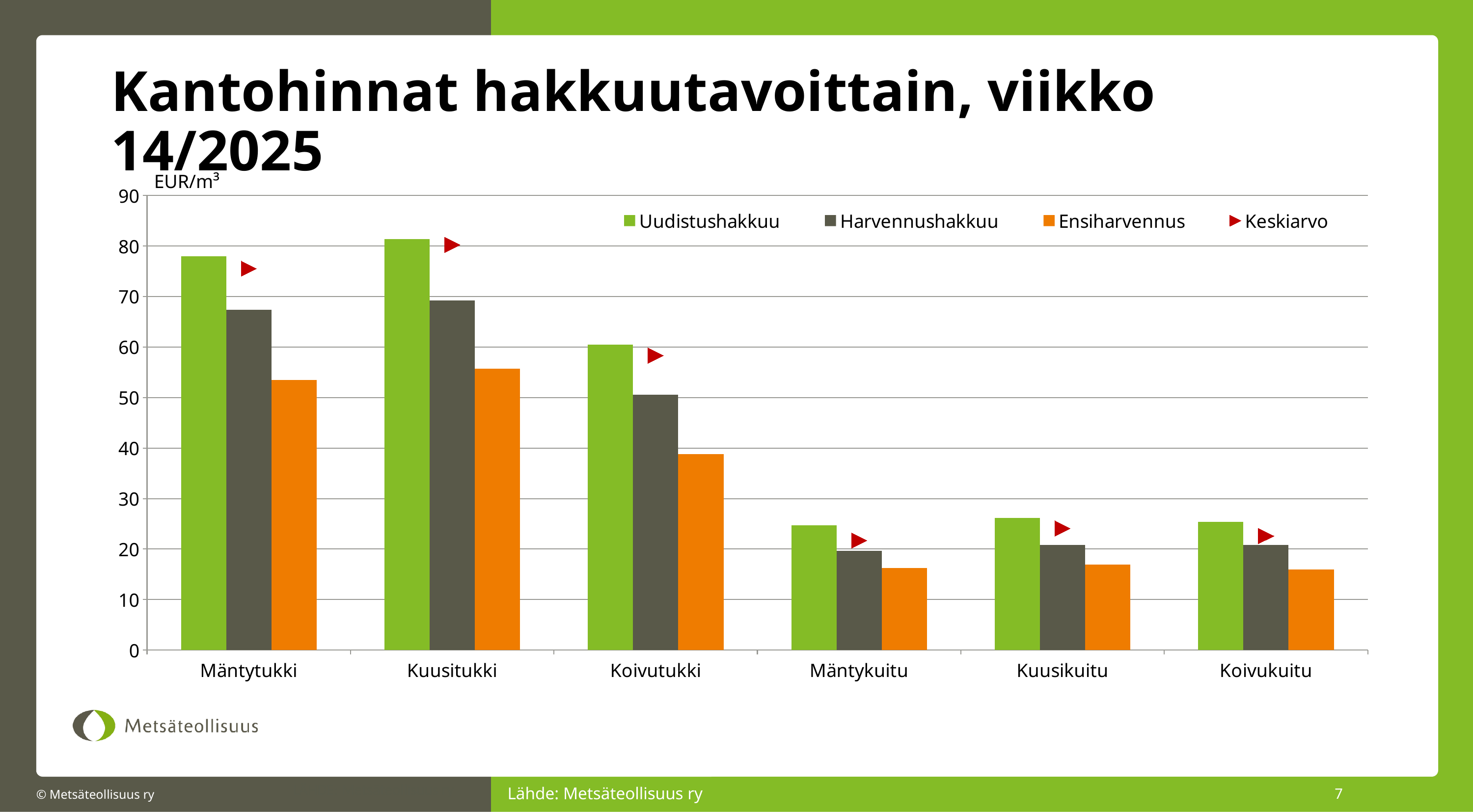
How many series does the legend list? 4 Which is larger: the Harvennushakkuu value for Mäntytukki or the Uudistushakkuu value for Koivutukki? Harvennushakkuu value for Mäntytukki Is the Keskiarvo marker for Kuusitukki greater or less than 70? greater Which is larger: the Uudistushakkuu value for Koivutukki or the Uudistushakkuu value for Kuusikuitu? Uudistushakkuu value for Koivutukki Is the Ensiharvennus value for Koivutukki greater or less than 50? less Is the Harvennushakkuu value for Mäntykuitu greater or less than 30? less What unit is shown on the y axis of the chart? EUR/m³ What kind of chart is shown on the slide? bar chart How many categories are shown on the x axis of the chart? 6 Which category has the highest Ensiharvennus value? Kuusitukki Which category has the highest Uudistushakkuu value? Kuusitukki